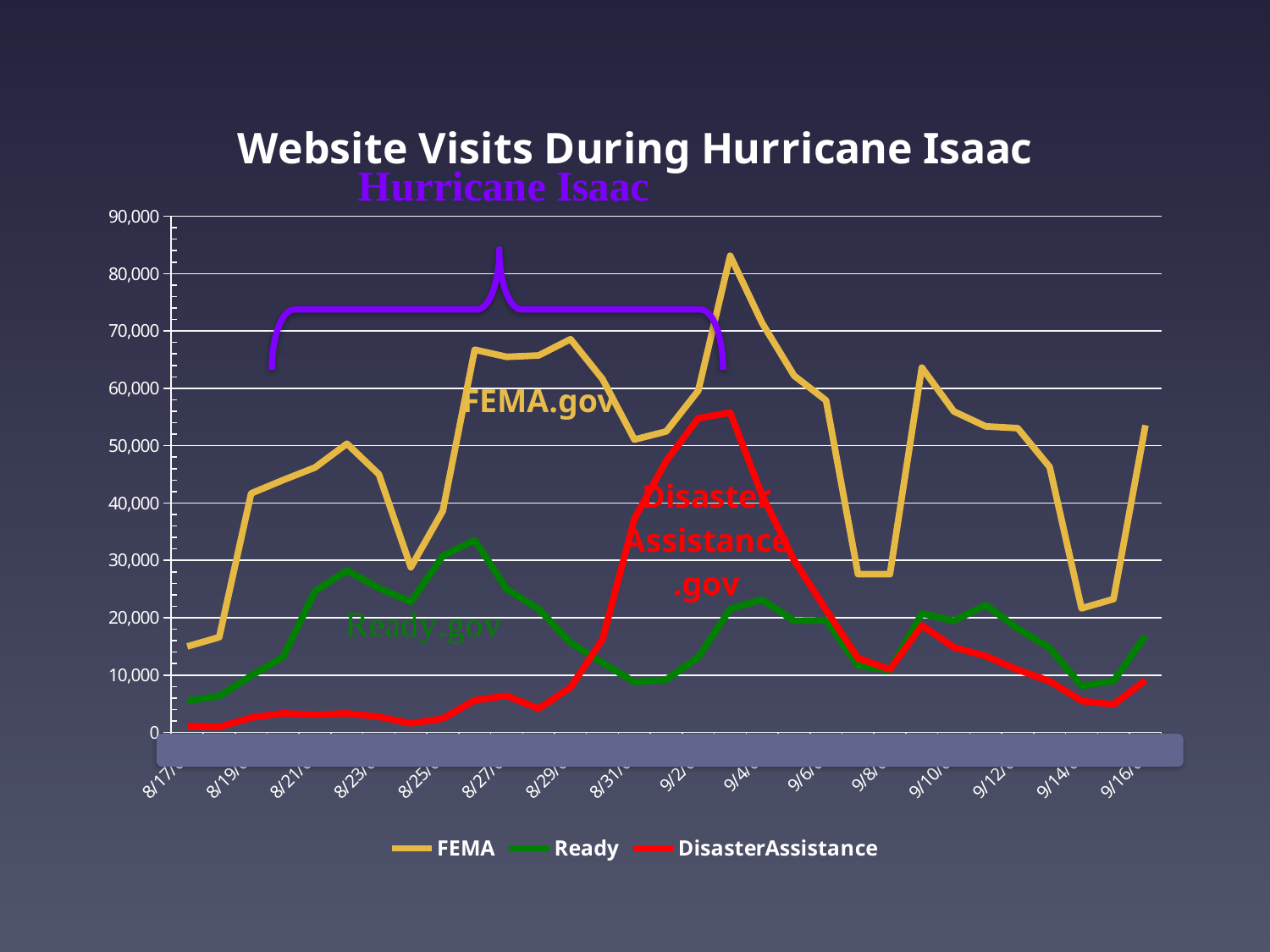
Which series has the lowest value at 8/17? DisasterAssistance At 8/21, which is larger: the Ready value or the DisasterAssistance value? Ready How many series does the legend list? 3 Is the peak value of the DisasterAssistance series greater or less than 50,000? greater Is the value for Ready at 8/17 greater or less than 10,000? less Does the DisasterAssistance series rise or fall between 9/4 and 9/8? Fall What kind of chart is shown on the slide? Line chart Is the value for FEMA at 9/8 greater or less than 30,000? less Which colour is used for the DisasterAssistance series? Red What is the title of the chart? Website Visits During Hurricane Isaac Which series reaches the highest value on the chart? FEMA